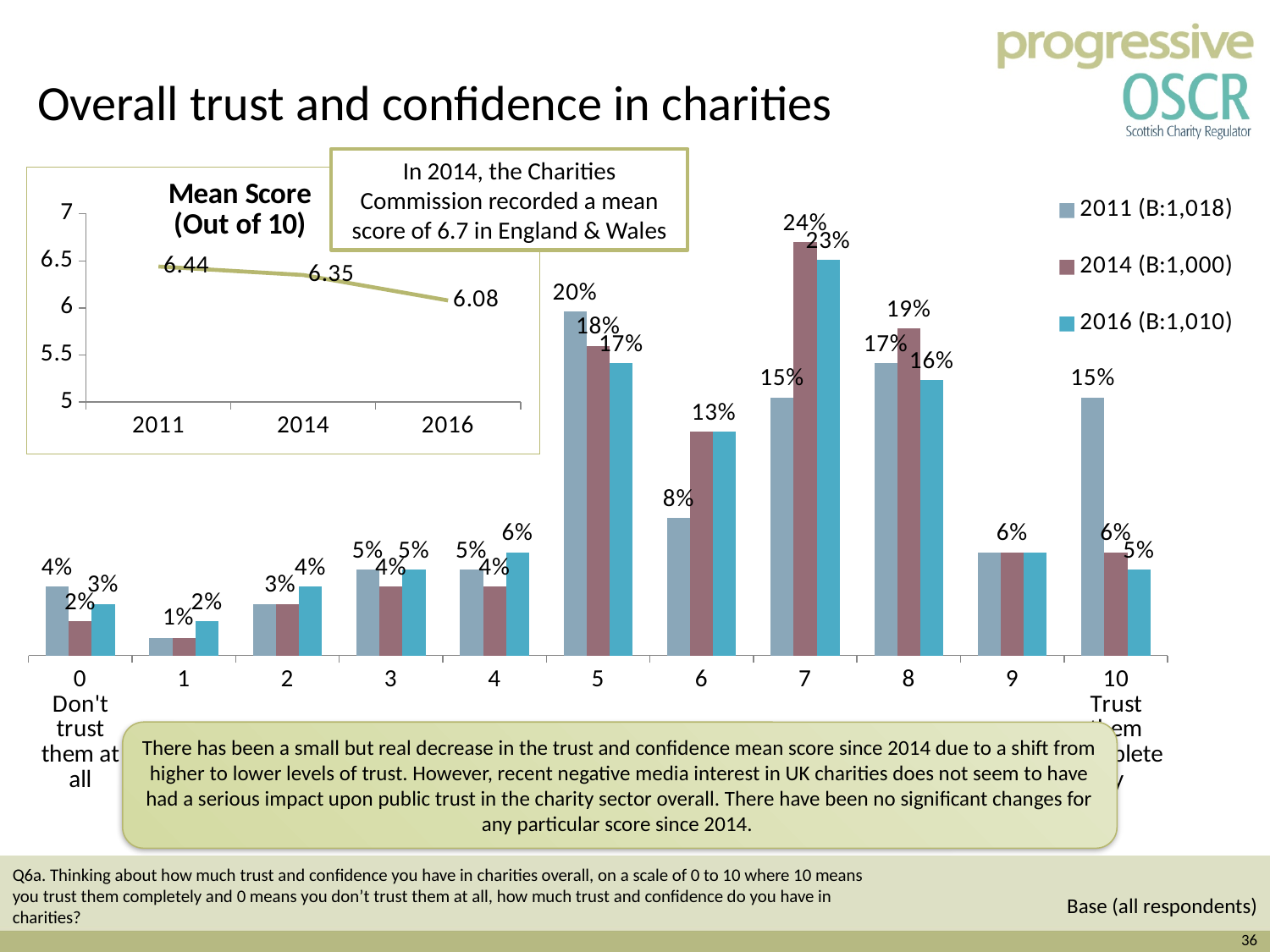
In the main bar chart, what percentage of 2014 respondents gave a trust score of 7? 24% In the Mean Score (Out of 10) chart, what is the mean score for 2011? 6.44 How many series does the legend of the main bar chart list? 3 In the main bar chart, which trust score has the highest value for the 2014 series? 7 In the main bar chart, for a trust score of 5, which is larger: the 2011 value or the 2014 value? 2011 In the Mean Score (Out of 10) chart, what is the mean score for 2016? 6.08 In the main bar chart, what is the difference between the 2011 and 2016 values for a trust score of 10? 10 percentage points In the Mean Score (Out of 10) chart, do the values rise or fall from 2011 to 2016? fall In the main bar chart, what percentage of 2011 respondents gave a trust score of 10? 15% In the Mean Score (Out of 10) chart, what is the difference between the 2011 and 2016 mean scores? 0.36 How many trust score categories are shown on the x axis of the main bar chart? 11 What kind of chart is the Mean Score (Out of 10) chart? line chart